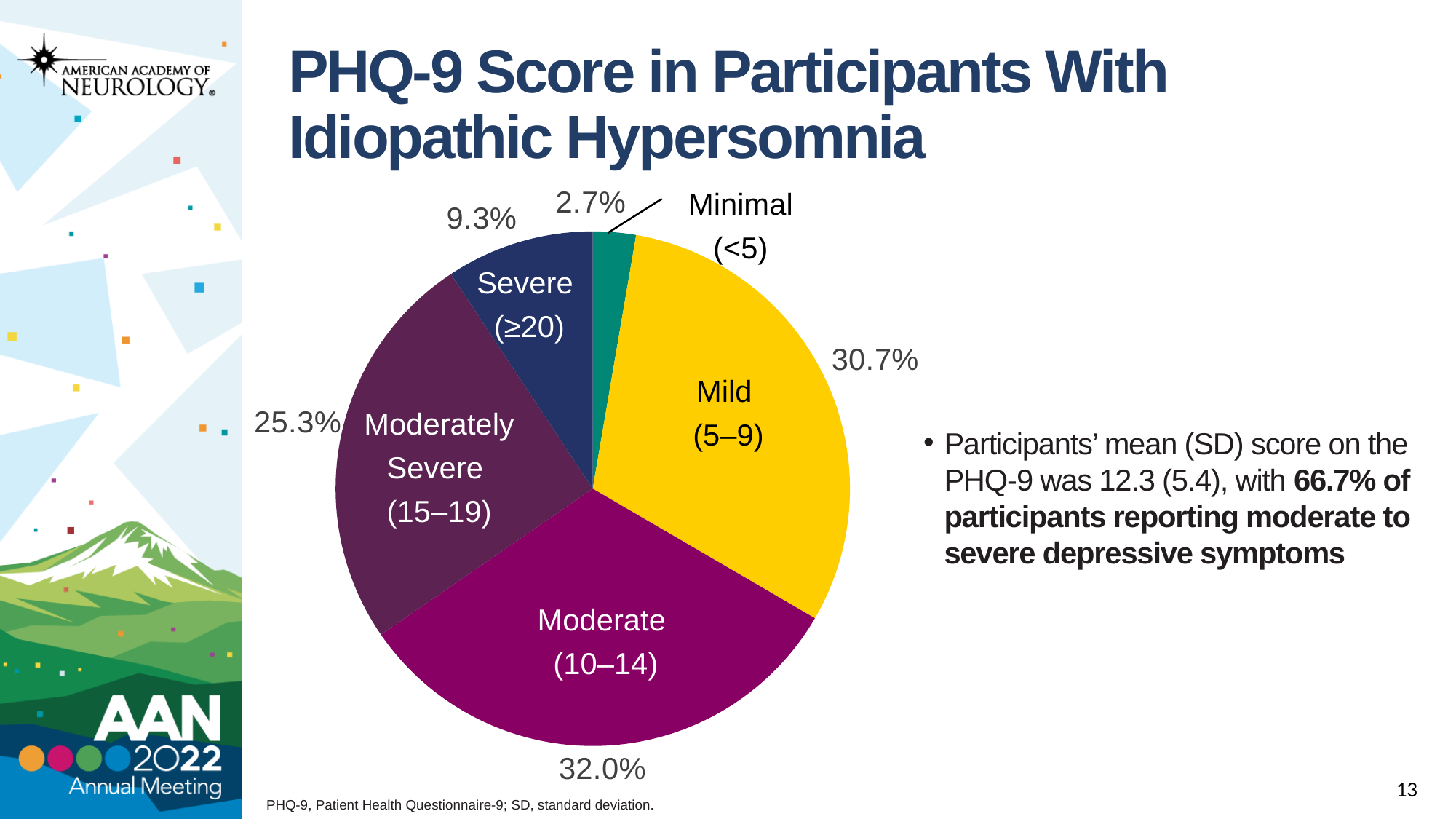
Which slice is larger: Mild (5–9) or Moderately Severe (15–19)? Mild (5–9) What colour is the Mild (5–9) slice of the pie chart? Yellow How many PHQ-9 score categories are shown in the pie chart? 5 What is the combined percentage of the Moderate (10–14), Moderately Severe (15–19) and Severe (≥20) slices? 66.6% What percentage of participants had a Severe (≥20) PHQ-9 score? 9.3% Which PHQ-9 score category has the smallest share of participants? Minimal (<5) What percentage of participants had a Minimal (<5) PHQ-9 score? 2.7% What kind of chart is shown on the slide? Pie chart What percentage of participants had a Mild (5–9) PHQ-9 score? 30.7% Which PHQ-9 score category has the largest share of participants? Moderate (10–14) What is the difference in percentage points between the Moderately Severe (15–19) and Severe (≥20) slices? 16.0 What percentage of participants had a Moderate (10–14) PHQ-9 score? 32.0%